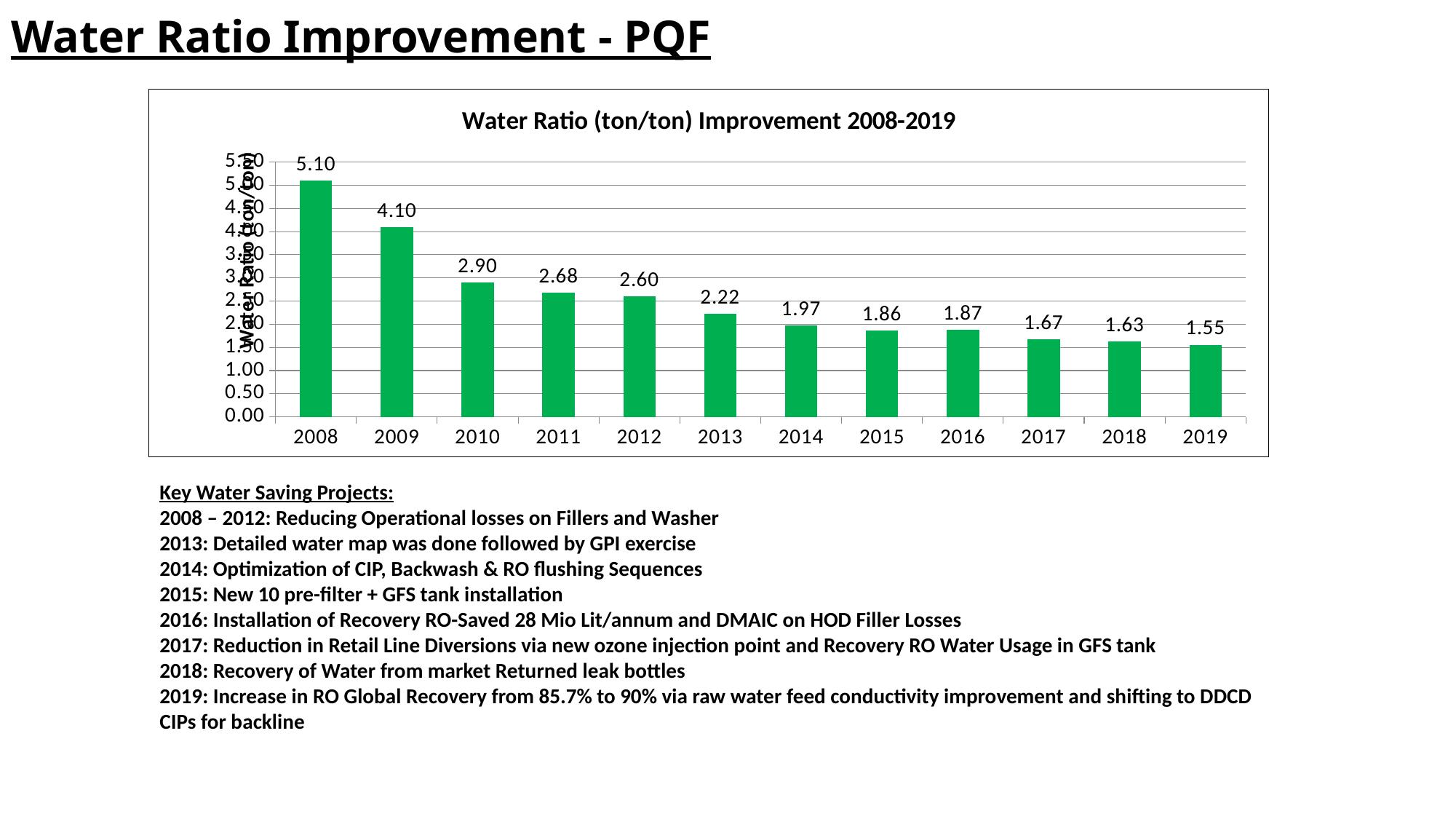
What kind of chart is shown on the slide? Bar chart Do the water ratio values generally rise or fall from 2008 to 2019? Fall What is the difference between the water ratio in 2008 and in 2019? 3.55 What is the water ratio value for 2019? 1.55 What is the water ratio value for 2008? 5.10 How many years are shown on the x axis of the chart? 12 Which year has the lowest water ratio? 2019 Which year has a larger water ratio, 2011 or 2013? 2011 What is the water ratio value for 2014? 1.97 What is the title of the chart? Water Ratio (ton/ton) Improvement 2008-2019 Which year has the highest water ratio? 2008 What is the difference between the water ratio in 2009 and in 2010? 1.20